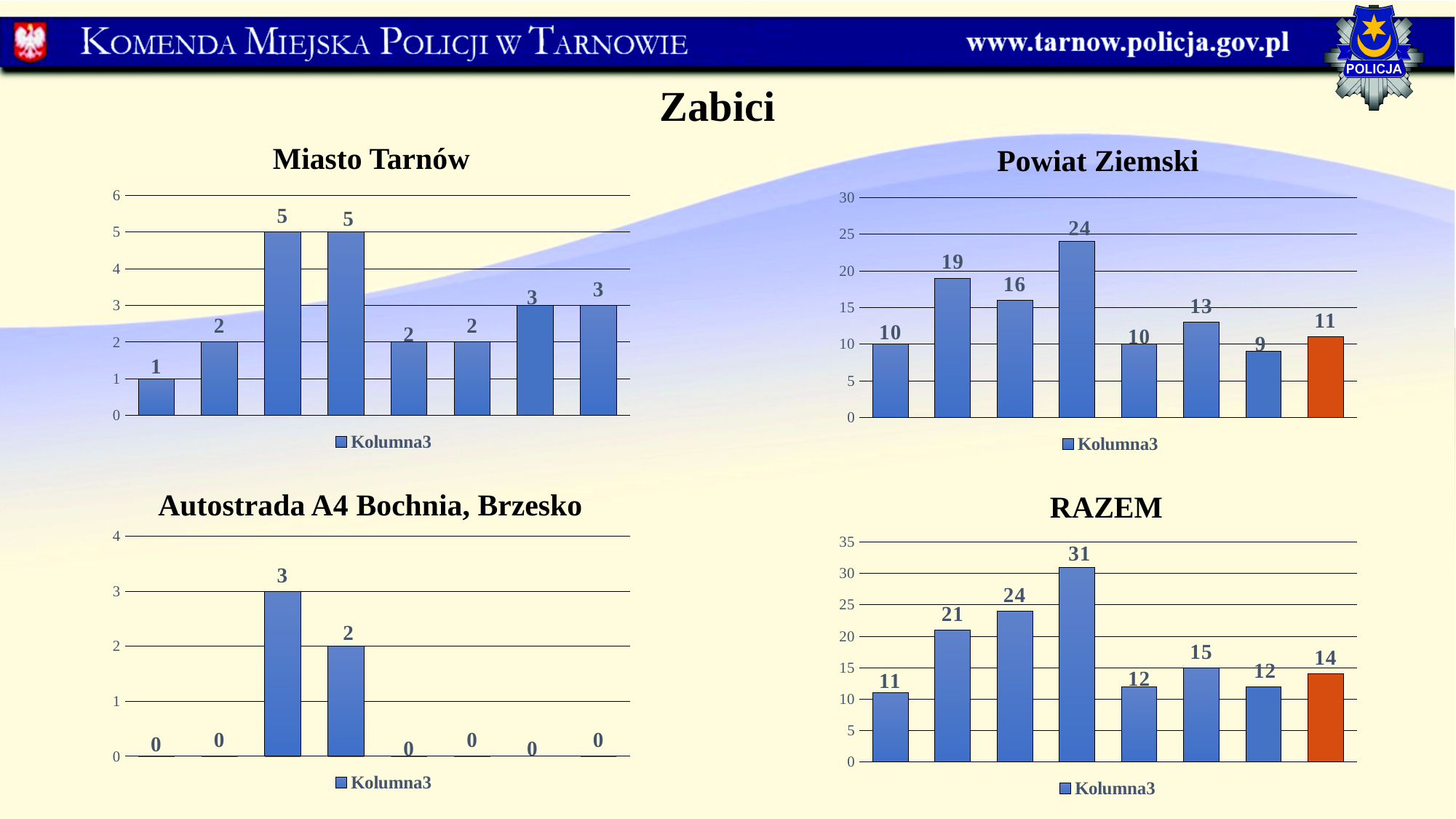
In the 'Powiat Ziemski' chart, what is the lowest value shown? 9 In the 'RAZEM' chart, what is the value of the tallest bar? 31 In the 'Powiat Ziemski' chart, what is the highest value shown? 24 What type of chart is the 'RAZEM' chart? bar chart In the 'Autostrada A4 Bochnia, Brzesko' chart, what is the value of the third bar? 3 In the 'RAZEM' chart, what is the value of the orange (last) bar? 14 How many bars are shown in the 'Miasto Tarnów' chart? 8 In the 'Powiat Ziemski' chart, is the second bar's value larger or smaller than the third bar's value? larger In the 'RAZEM' chart, what is the difference between the highest value and the first bar's value? 20 What series name does the legend show under the 'Autostrada A4 Bochnia, Brzesko' chart? Kolumna3 In the 'Powiat Ziemski' chart, what is the value of the orange (last) bar? 11 In the 'Miasto Tarnów' chart, what is the value of the first bar? 1